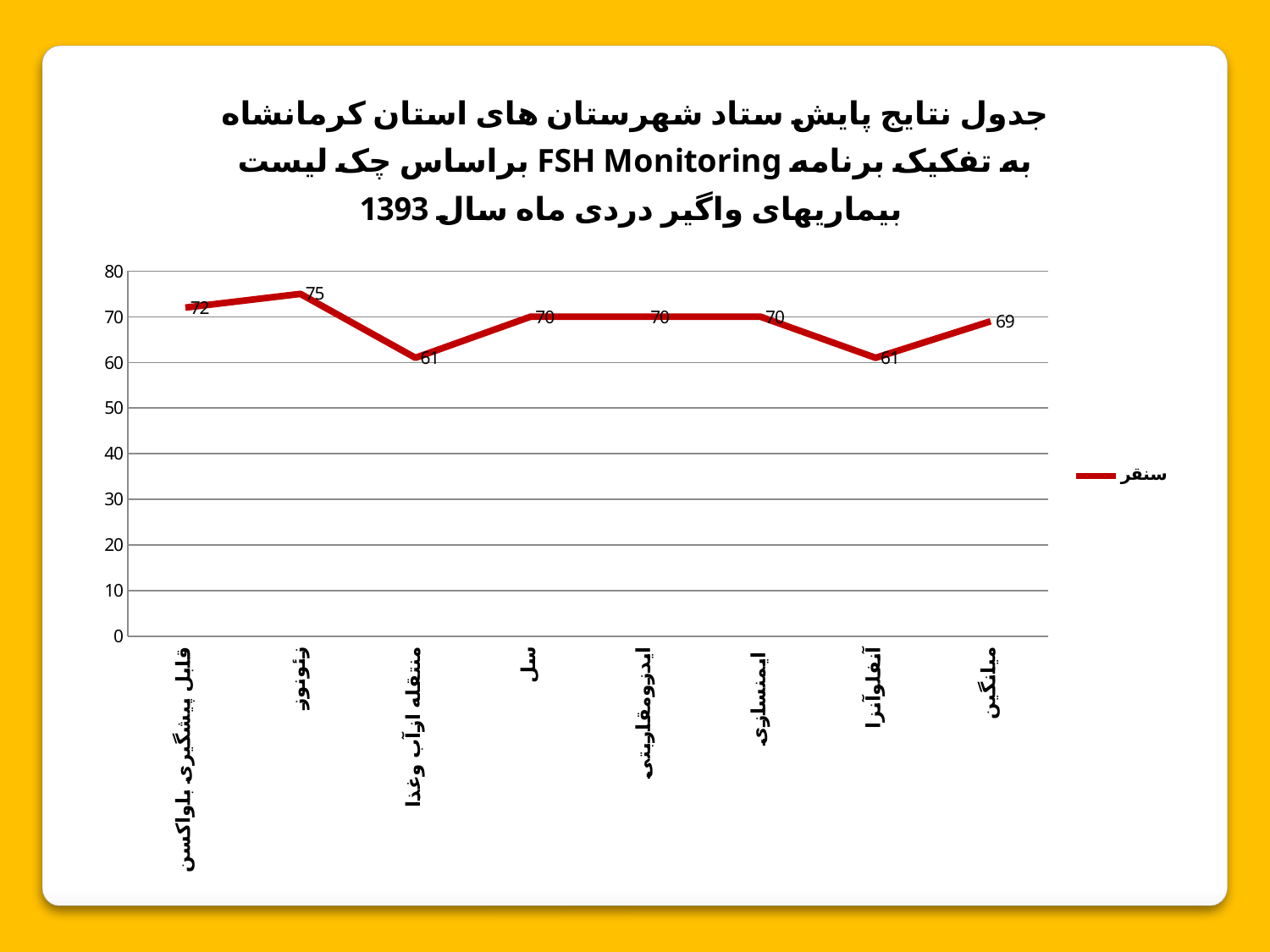
What is the value for آنفلوآنزا? 61 Which category has the highest value? زئونوز What kind of chart is shown on the slide? line chart How many series does the legend list? 1 What is the value for میانگین? 69 Which is larger, the value for قابل پیشگیری با واکسن or the value for سل? قابل پیشگیری با واکسن What is the value for زئونوز? 75 What is the name of the series shown in the legend? سنقر How many categories are shown on the x axis? 8 What is the value for قابل پیشگیری با واکسن? 72 Is the value for آنفلوآنزا greater or less than 70? less What is the difference between the values for زئونوز and منتقله از آب و غذا? 14